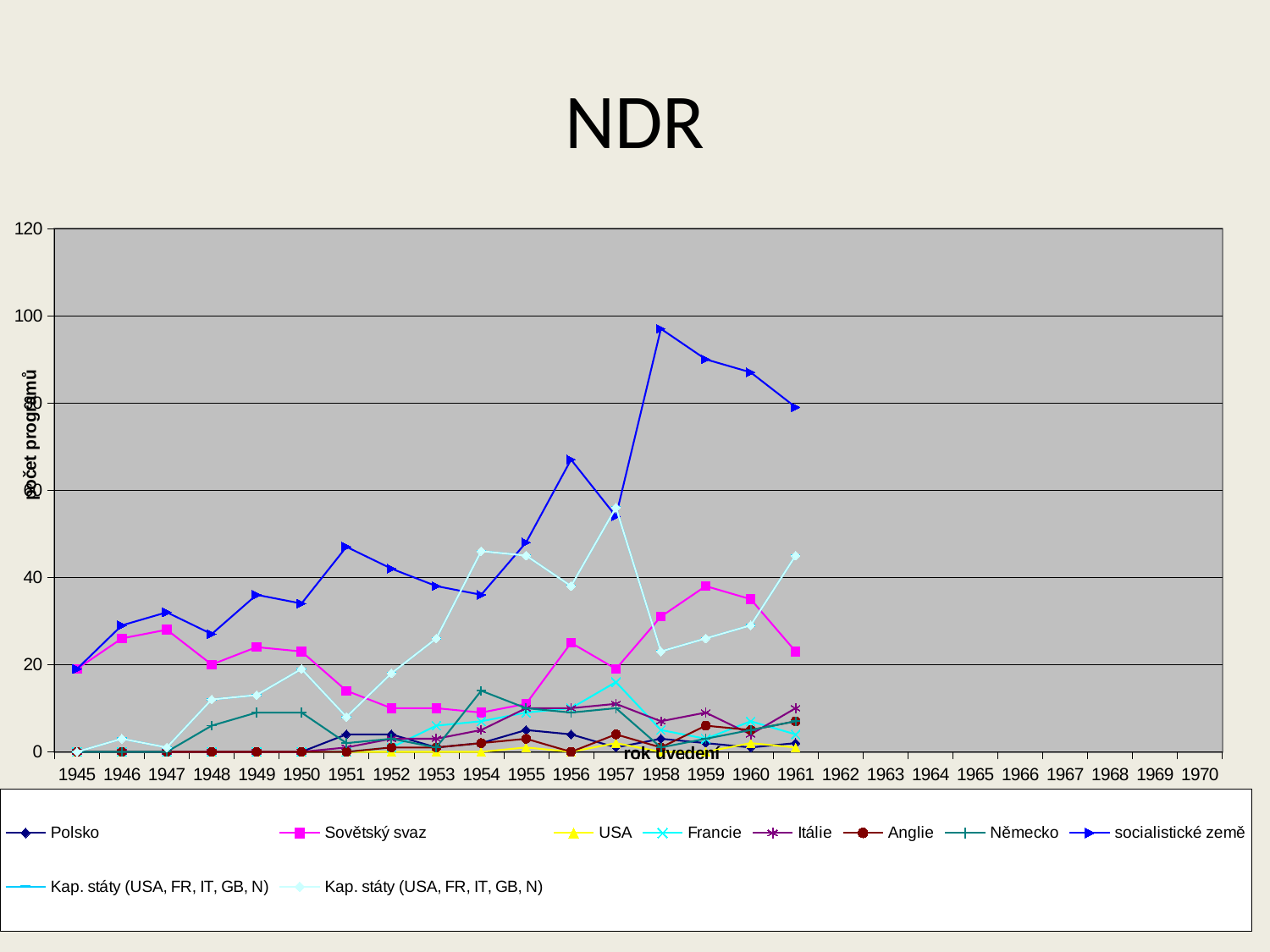
What is the title of the chart? NDR How many years are labelled on the x axis? 26 Is the value for socialistické země in 1961 greater or less than 100? less Is the value for socialistické země in 1958 greater or less than 80? greater How many series does the legend list? 10 Is the value for Sovětský svaz in 1961 greater or less than 40? less What is the label of the y axis? počet programů What kind of chart is shown on the slide? line chart Does the socialistické země series rise or fall from 1958 to 1961? fall In which year does the socialistické země series reach its peak? 1958 In 1958, which is larger: the value for socialistické země or the value for Sovětský svaz? socialistické země Which series reaches the highest value on the chart? socialistické země